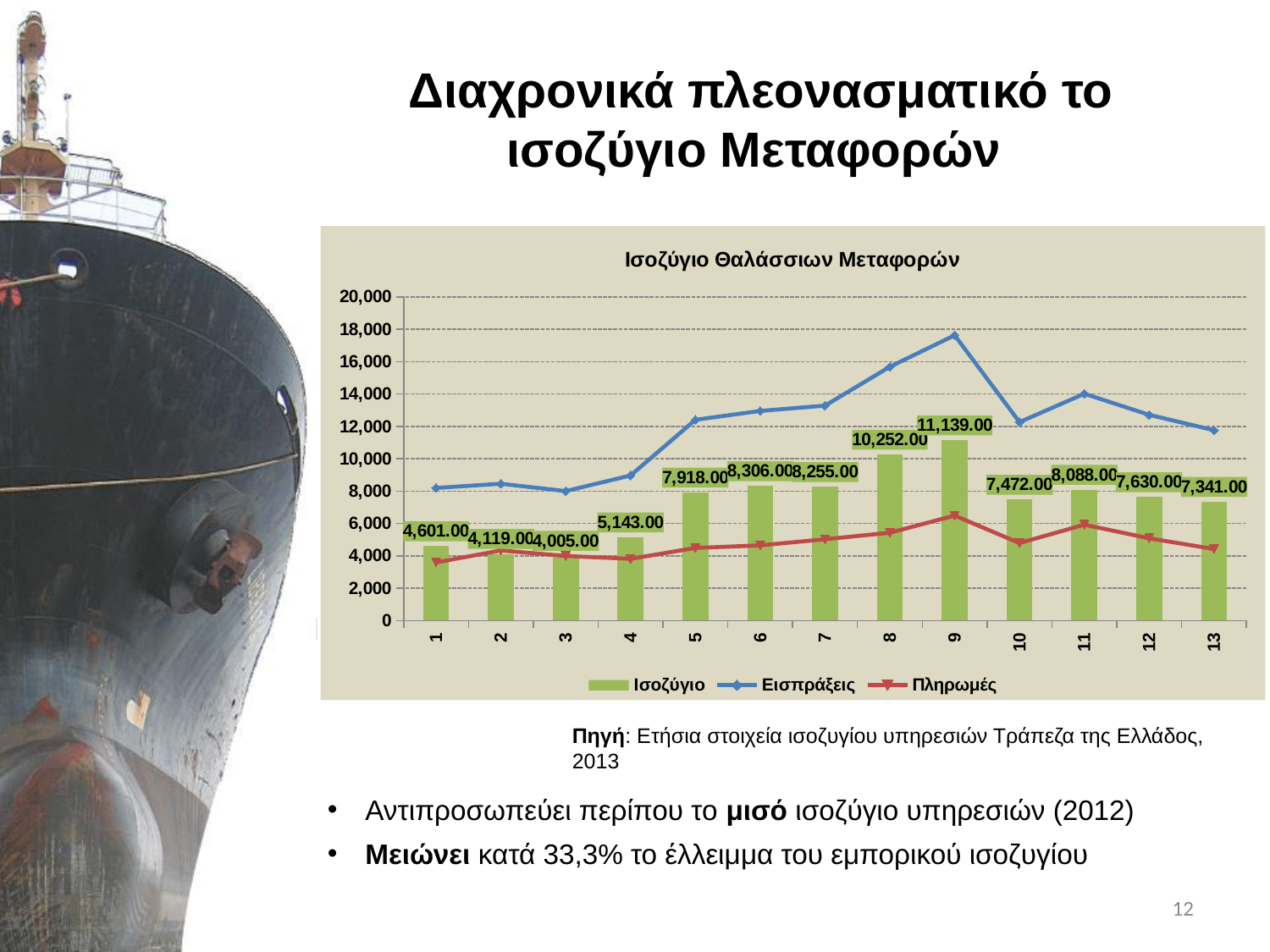
What is the value of Ισοζύγιο for category 13? 7,341.00 What is the value of Ισοζύγιο for category 1? 4,601.00 What is the title of the chart? Ισοζύγιο Θαλάσσιων Μεταφορών What is the difference between the Ισοζύγιο values for categories 9 and 8? 887.00 Which is larger, the Ισοζύγιο value for category 4 or for category 5? 5 How many series does the legend list? 3 What is the value of Ισοζύγιο for category 9? 11,139.00 How many categories are shown on the x axis? 13 Is the Πληρωμές value for category 1 greater or less than 4,000? less Which category has the highest Ισοζύγιο value? 9 Is the Εισπράξεις value for category 9 greater or less than 16,000? greater Which category has the lowest Ισοζύγιο value? 3